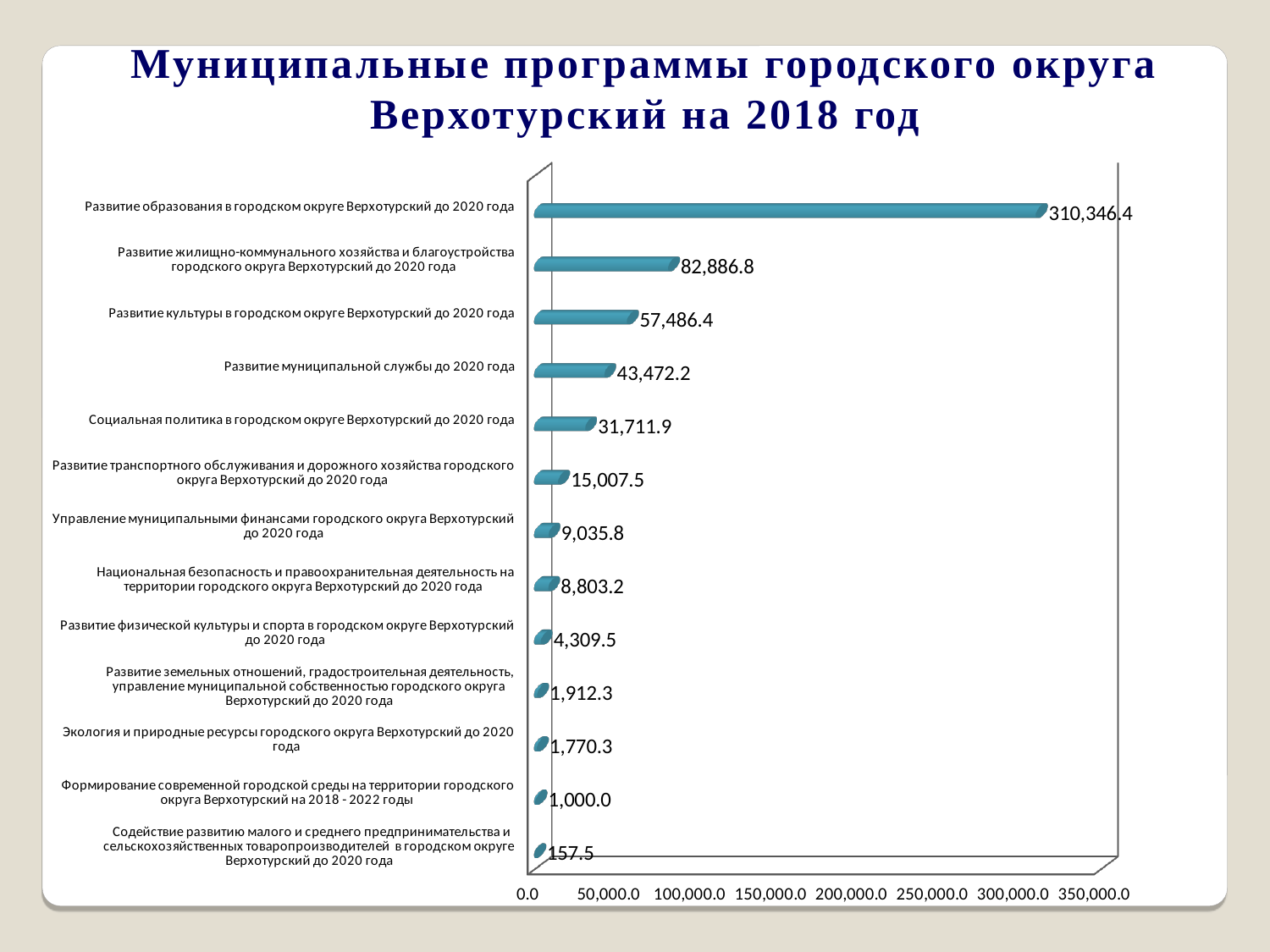
Which is larger: the value for 'Управление муниципальными финансами' or for 'Национальная безопасность и правоохранительная деятельность'? Управление муниципальными финансами What is the value for 'Развитие образования в городском округе Верхотурский до 2020 года'? 310,346.4 Is the value for 'Развитие муниципальной службы до 2020 года' greater or less than 50,000.0? less What is the value for 'Социальная политика в городском округе Верхотурский до 2020 года'? 31,711.9 What kind of chart is shown on the slide? bar chart What is the difference between the values for 'Развитие жилищно-коммунального хозяйства и благоустройства' (82,886.8) and 'Развитие культуры' (57,486.4)? 25,400.4 How many municipal programmes (bars) are shown in the chart? 13 What is the value for 'Развитие культуры в городском округе Верхотурский до 2020 года'? 57,486.4 Which programme has the lowest value in the chart? Содействие развитию малого и среднего предпринимательства и сельскохозяйственных товаропроизводителей в городском округе Верхотурский до 2020 года Which programme has the highest value in the chart? Развитие образования в городском округе Верхотурский до 2020 года What is the title of the chart on the slide? Муниципальные программы городского округа Верхотурский на 2018 год What is the value for 'Экология и природные ресурсы городского округа Верхотурский до 2020 года'? 1,770.3